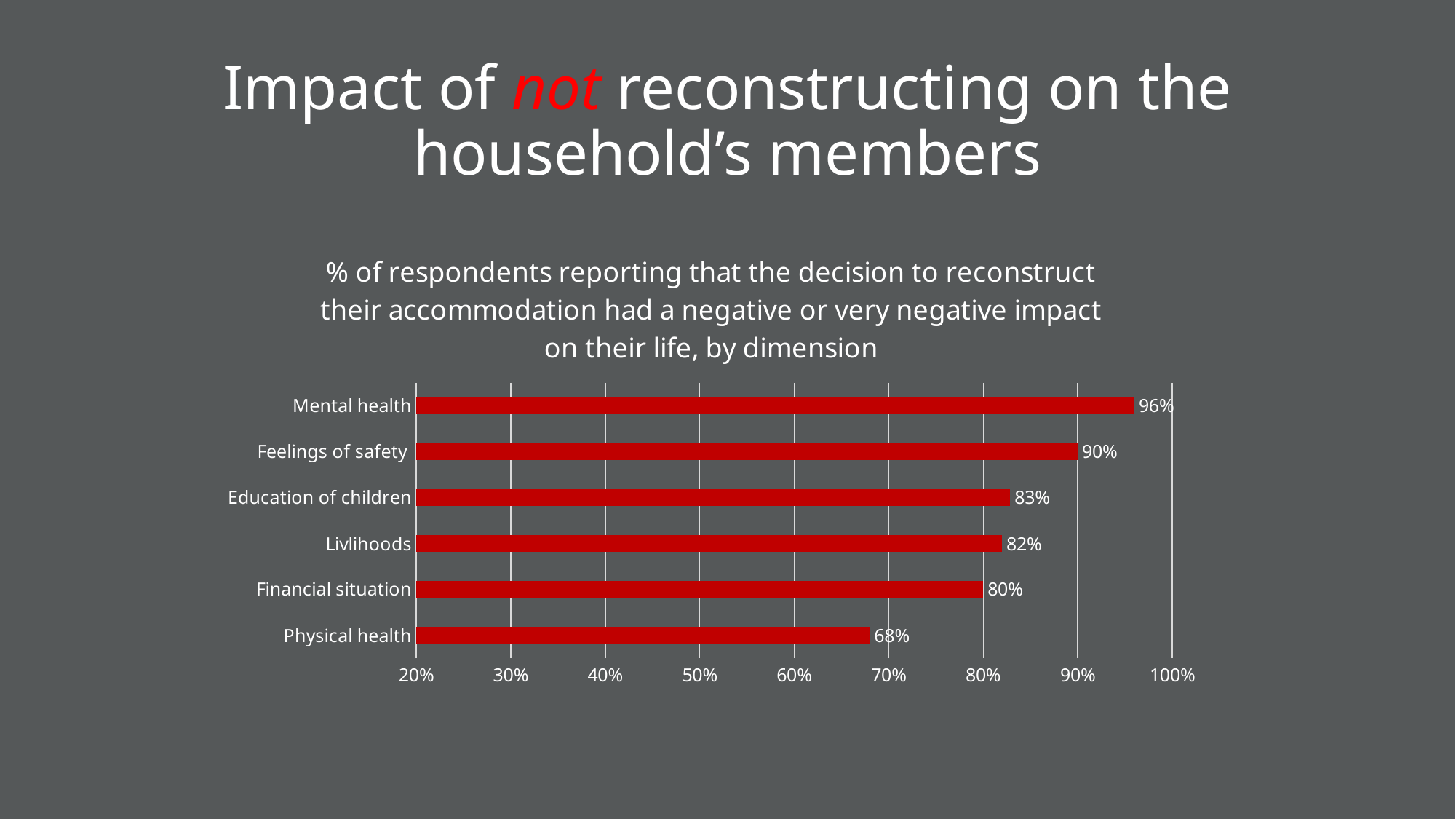
What percentage of respondents reported a negative or very negative impact on Mental health? 96% What kind of chart is shown on the slide? Bar chart Which dimension has the highest percentage of respondents reporting a negative impact? Mental health What colour are the bars in the chart? Red Which is larger, the value for Feelings of safety or the value for Livlihoods? Feelings of safety Which dimension has the lowest percentage of respondents reporting a negative impact? Physical health What is the difference in percentage points between Mental health and Physical health? 28 Is the value for Financial situation greater or less than 70%? greater What is the value shown for Physical health? 68% What is the value shown for Education of children? 83% What is the difference in percentage points between Feelings of safety and Financial situation? 10 How many dimensions are shown in the chart? 6